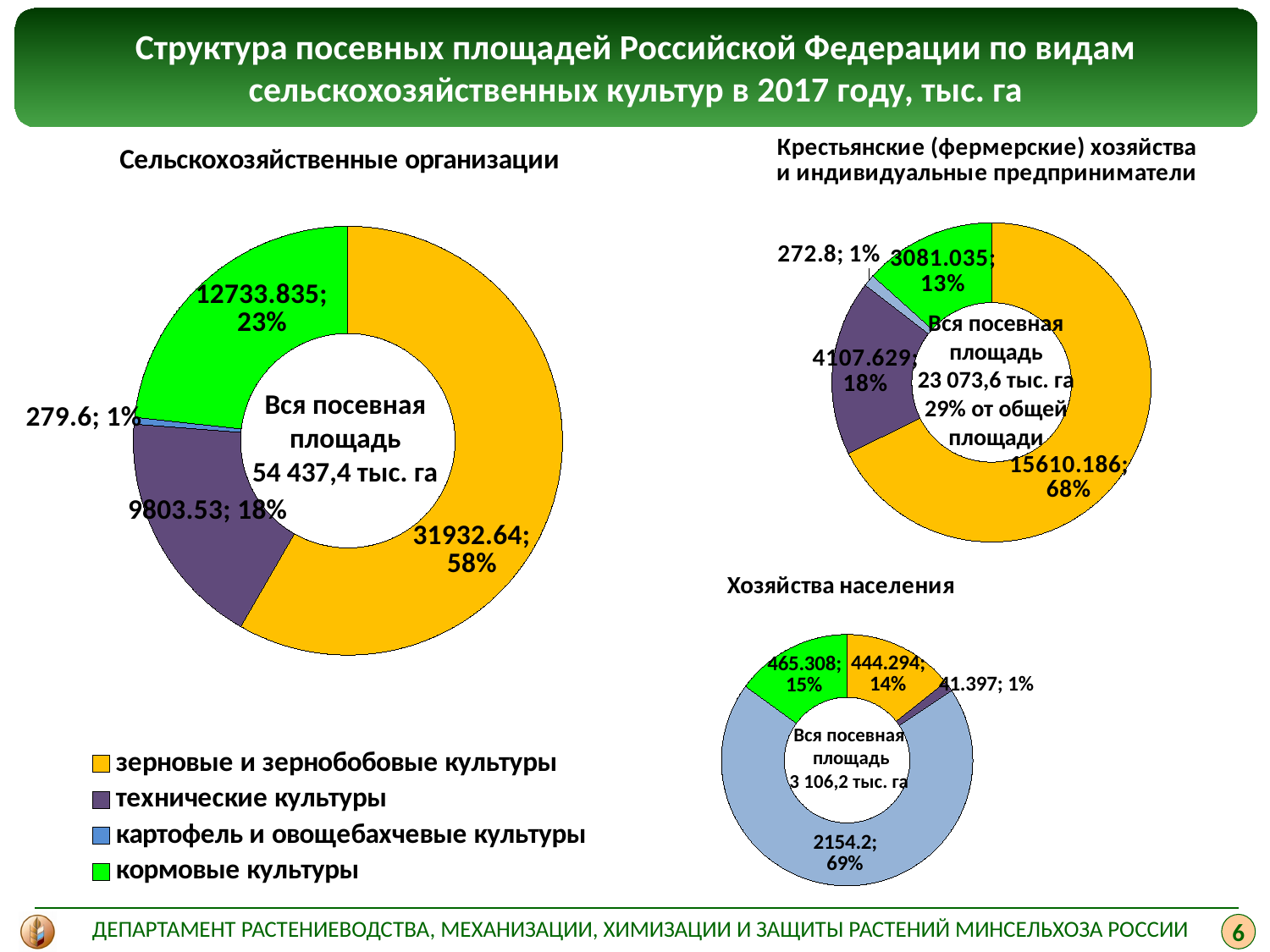
In the 'Хозяйства населения' chart, what value is shown for кормовые культуры? 465.308 In the 'Крестьянские (фермерские) хозяйства и индивидуальные предприниматели' chart, what share do зерновые и зернобобовые культуры have? 68% In the 'Сельскохозяйственные организации' chart, what value is shown for зерновые и зернобобовые культуры? 31932.64 In the 'Крестьянские (фермерские) хозяйства и индивидуальные предприниматели' chart, what value is shown for технические культуры? 4107.629 In the 'Сельскохозяйственные организации' chart, which category has the smallest slice? картофель и овощебахчевые культуры What type of chart is used on this slide? Doughnut (pie) chart In the 'Сельскохозяйственные организации' chart, what is the difference in percentage points between зерновые и зернобобовые культуры and технические культуры? 40 percentage points In the 'Сельскохозяйственные организации' chart, what share of the total do кормовые культуры have? 23% In the 'Хозяйства населения' chart, which category has the largest slice? картофель и овощебахчевые культуры In the 'Хозяйства населения' chart, which is larger: зерновые и зернобобовые культуры or кормовые культуры? кормовые культуры How many categories does the legend list? 4 What total sown area is shown in the centre of the 'Хозяйства населения' chart? 3 106,2 тыс. га